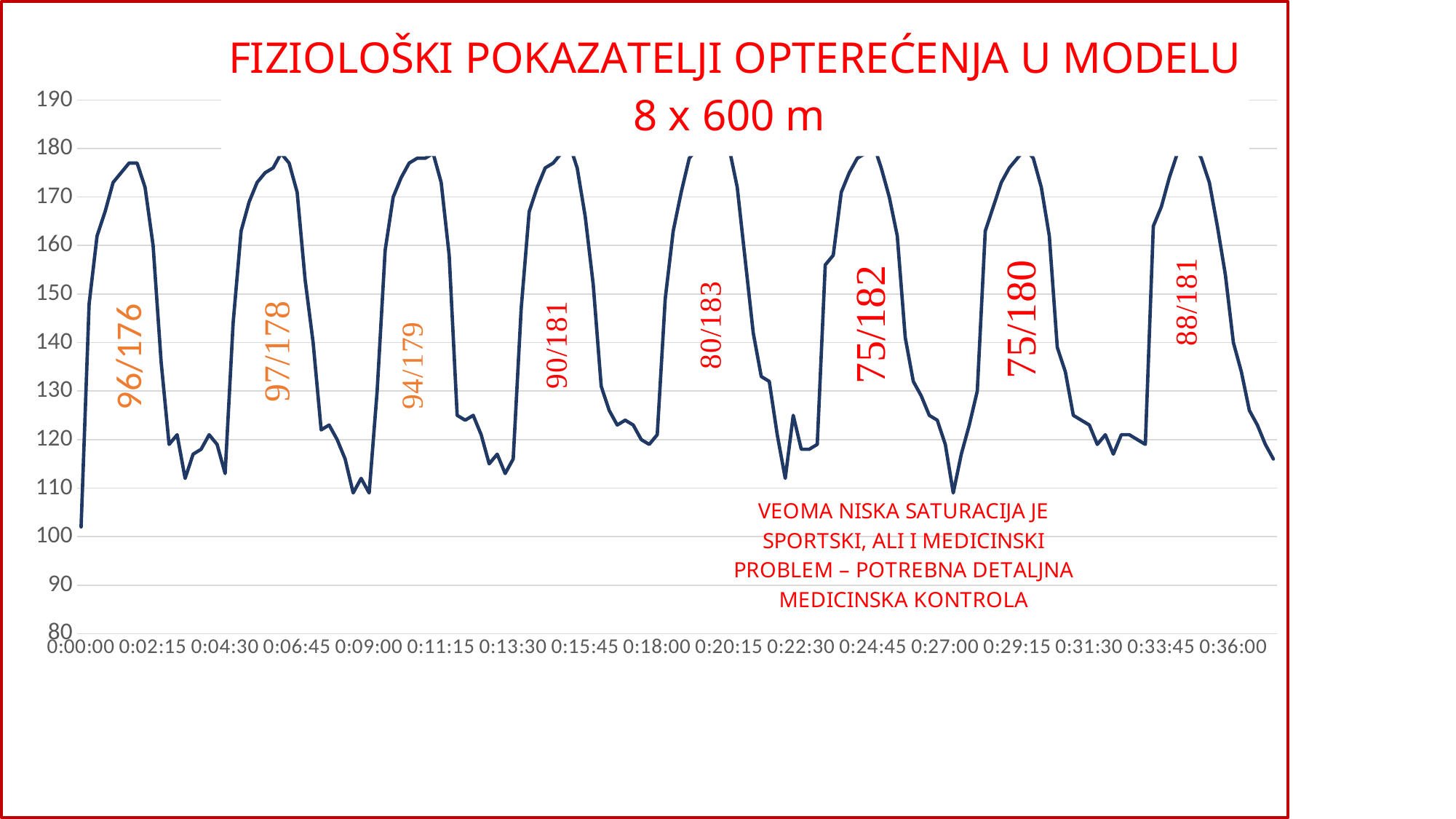
What is the title of the chart? FIZIOLOŠKI POKAZATELJI OPTEREĆENJA U MODELU 8 x 600 m What kind of chart is shown on the slide? line chart What annotation is written next to the third peak? 94/179 How many peaks (intervals) does the line show? 8 What annotation is written next to the last peak? 88/181 What annotation is written next to the first peak? 96/176 Is the value at the top of the first peak greater or less than 170? greater Is the value at the very start of the line (0:00:00) greater or less than 110? less Which annotation shows the lowest first number (saturation)? 75/182 and 75/180 What is the lowest value shown on the vertical axis? 80 What annotation is written next to the fifth peak? 80/183 What is the last time label on the horizontal axis? 0:36:00